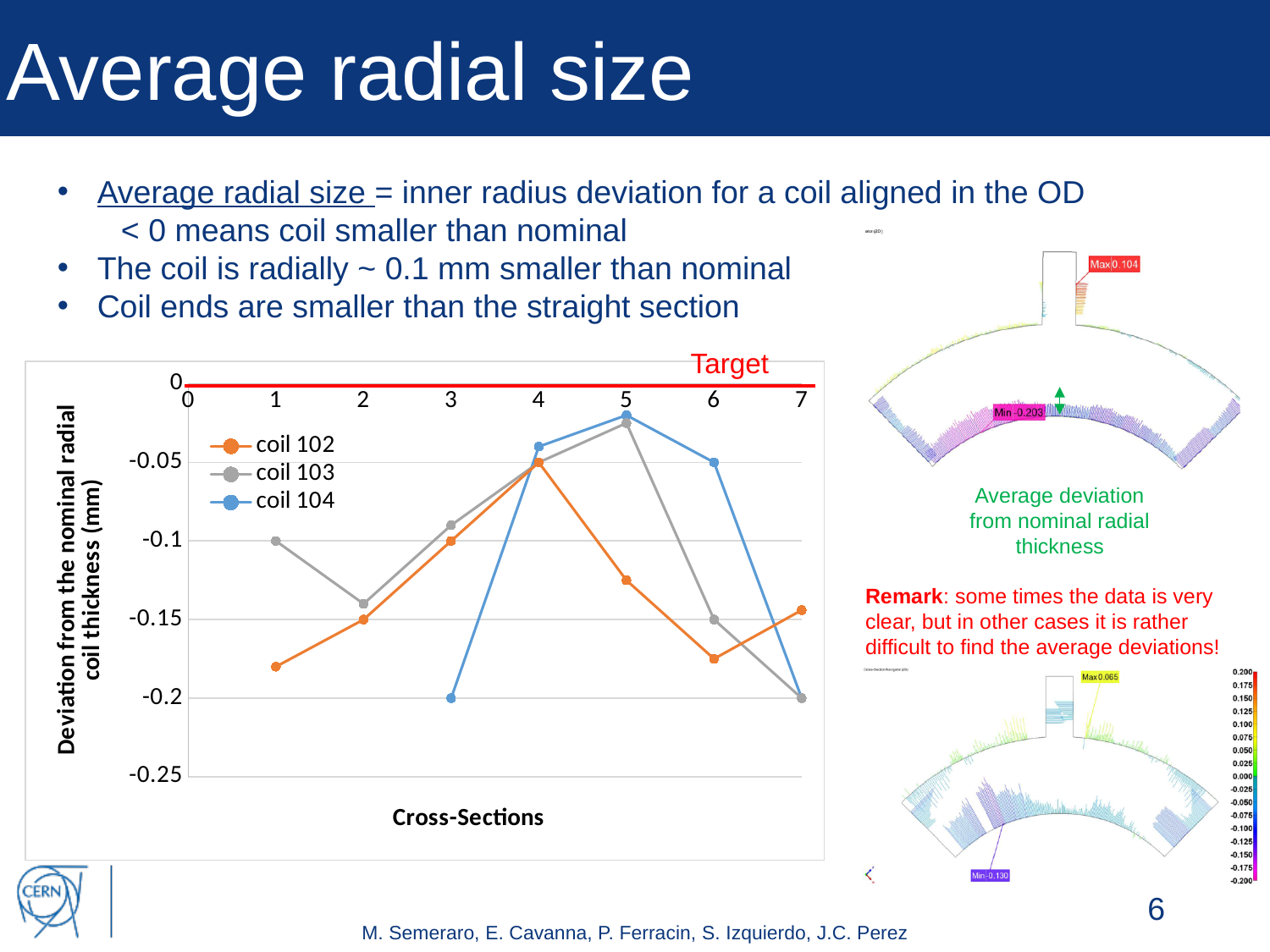
What is the title of the x axis of the chart? Cross-Sections What is the value for coil 104 at cross-section 3? -0.2 Is the value for coil 102 at cross-section 1 greater or less than -0.15? less At which cross-section does coil 102 reach its highest value? 4 What is the value for coil 104 at cross-section 6? -0.05 At cross-section 3, which is larger: the value for coil 103 or for coil 104? coil 103 Which series are listed in the chart legend? coil 102, coil 103, coil 104 At which cross-section does coil 103 reach its lowest value? 7 What is the value for coil 102 at cross-section 2? -0.15 How many series does the chart legend list? 3 What is the value for coil 103 at cross-section 1? -0.1 What kind of chart is shown on the slide? line chart